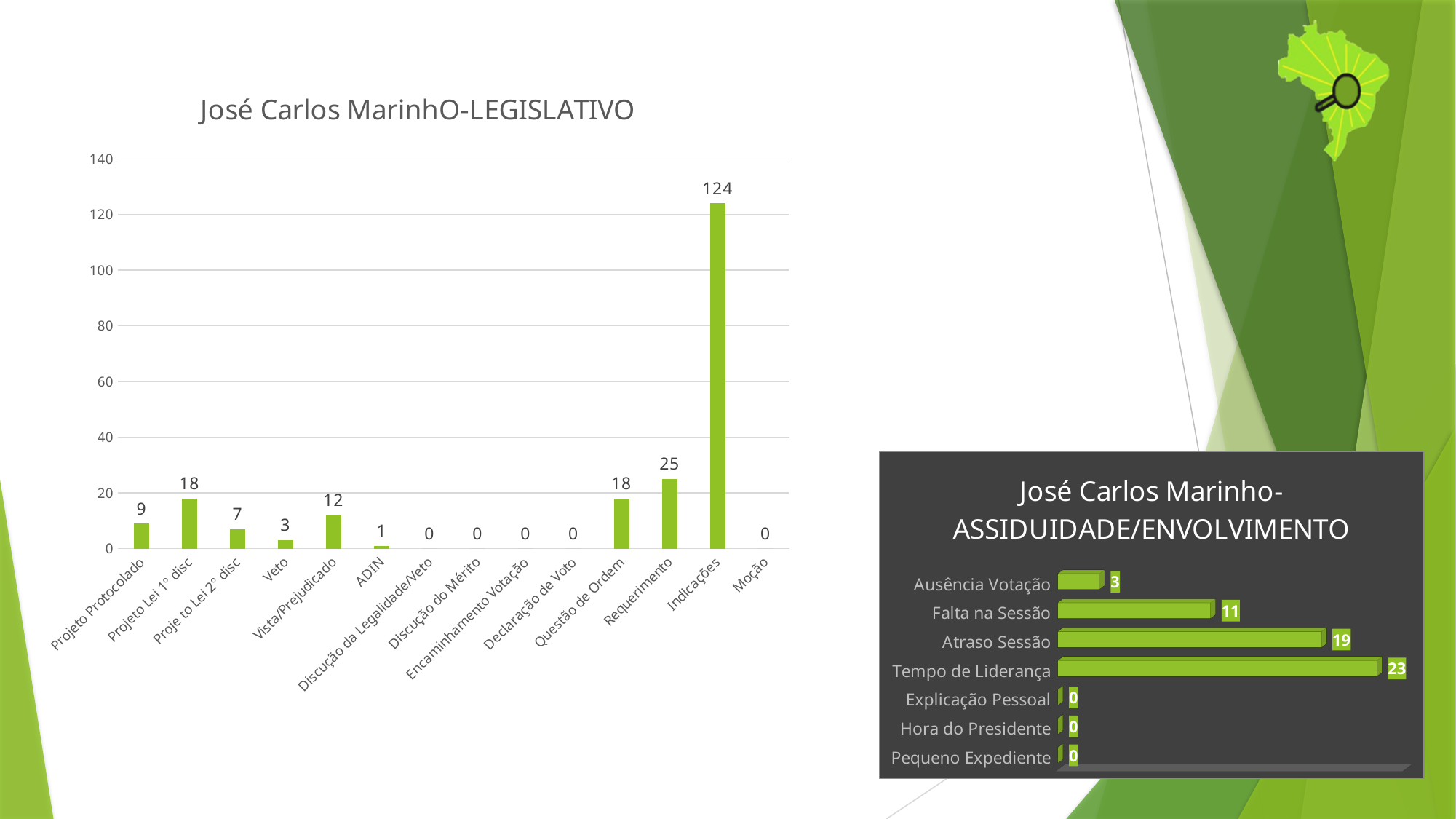
In the 'José Carlos MarinhO-LEGISLATIVO' chart, what is the difference between Requerimento and Questão de Ordem? 7 In the 'José Carlos Marinho-ASSIDUIDADE/ENVOLVIMENTO' chart, which category has the highest value? Tempo de Liderança In the 'José Carlos Marinho-ASSIDUIDADE/ENVOLVIMENTO' chart, what is the value for Atraso Sessão? 19 In the 'José Carlos Marinho-ASSIDUIDADE/ENVOLVIMENTO' chart, how many categories are listed? 7 In the 'José Carlos MarinhO-LEGISLATIVO' chart, which is larger: Projeto Protocolado or Vista/Prejudicado? Vista/Prejudicado What kind of chart is 'José Carlos MarinhO-LEGISLATIVO'? Bar chart In the 'José Carlos MarinhO-LEGISLATIVO' chart, which category has the highest value? Indicações In the 'José Carlos Marinho-ASSIDUIDADE/ENVOLVIMENTO' chart, which is larger: Ausência Votação or Falta na Sessão? Falta na Sessão In the 'José Carlos Marinho-ASSIDUIDADE/ENVOLVIMENTO' chart, what is the difference between Tempo de Liderança and Falta na Sessão? 12 In the 'José Carlos MarinhO-LEGISLATIVO' chart, what is the value for Indicações? 124 In the 'José Carlos MarinhO-LEGISLATIVO' chart, how many categories are shown on the x axis? 14 In the 'José Carlos MarinhO-LEGISLATIVO' chart, what is the value for Requerimento? 25